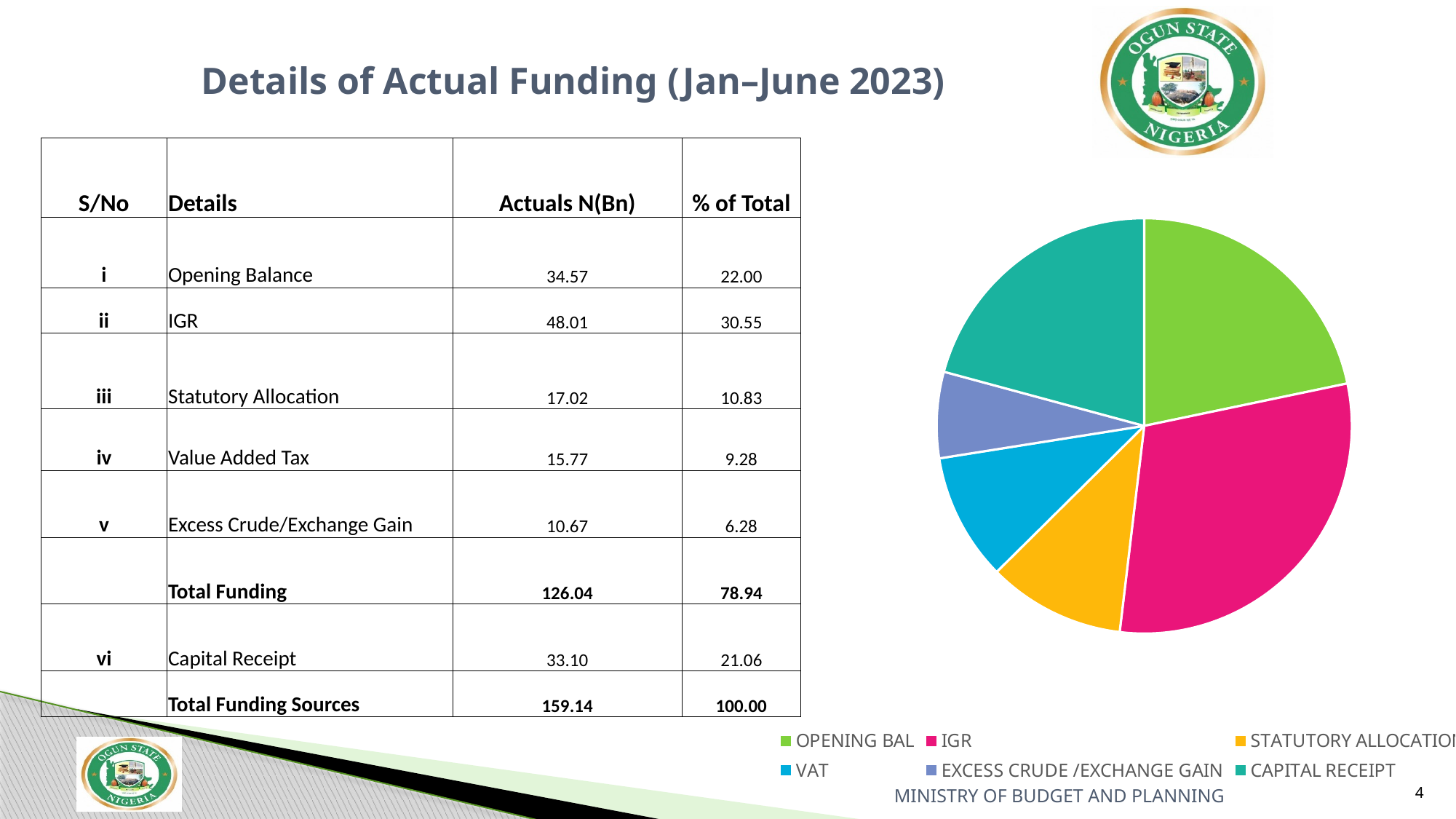
Which category has the largest slice in the pie chart? IGR According to the table, what share of the total does IGR represent? 30.55 Which slice is larger in the pie chart, OPENING BAL or STATUTORY ALLOCATION? OPENING BAL Which slice is larger in the pie chart, CAPITAL RECEIPT or VAT? CAPITAL RECEIPT According to the table, what share of the total does Capital Receipt represent? 21.06 What kind of chart is shown on the slide? pie chart What colour is the IGR slice in the pie chart? pink/magenta How many entries does the pie chart's legend list? 6 Which category has the smallest slice in the pie chart? EXCESS CRUDE /EXCHANGE GAIN What is the actual funding value (N Bn) for Value Added Tax in the table? 15.77 How many slices does the pie chart have? 6 What is the difference in Actuals N(Bn) between IGR and Opening Balance in the table? 13.44